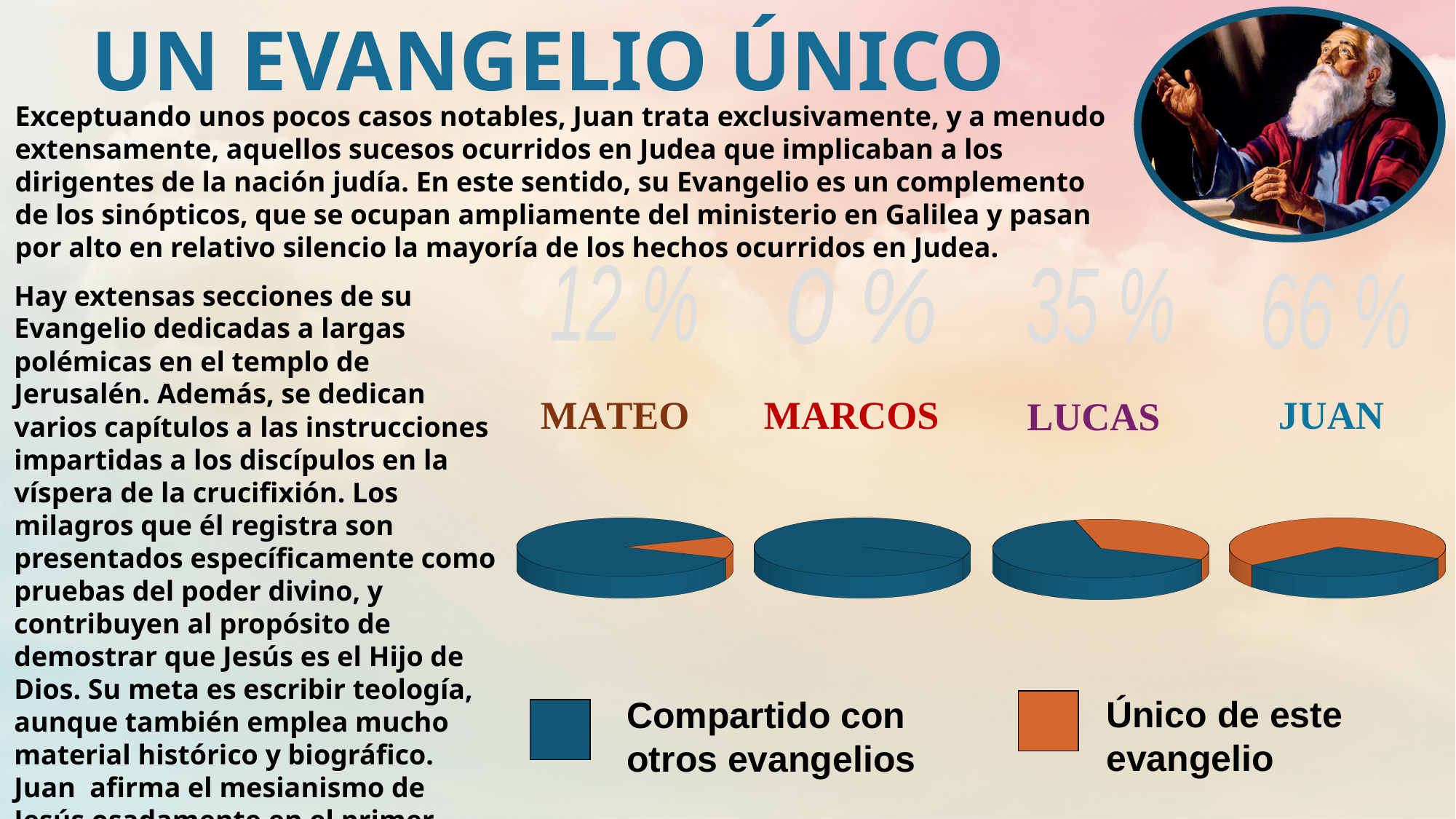
Which colour in the legend represents 'Único de este evangelio'? Orange In the JUAN pie chart, what percentage is printed above it for the material unique to this gospel? 66 % In the MATEO pie chart, what percentage is printed above it? 12 % In the LUCAS pie chart, what percentage is printed above it? 35 % How many pie charts are shown on the slide? 4 In the MARCOS pie chart, what percentage is printed above it? 0 % What is the difference between the percentage printed above the JUAN pie chart and the one printed above the LUCAS pie chart? 31 % Which gospel's pie chart has the smallest 'Único de este evangelio' slice? MARCOS What kind of charts are shown on the slide for Mateo, Marcos, Lucas and Juan? Pie charts Which pie chart has a larger orange 'Único de este evangelio' slice, LUCAS or MATEO? LUCAS Which gospel's pie chart has the largest 'Único de este evangelio' slice? JUAN How many entries does the legend below the pie charts list? 2